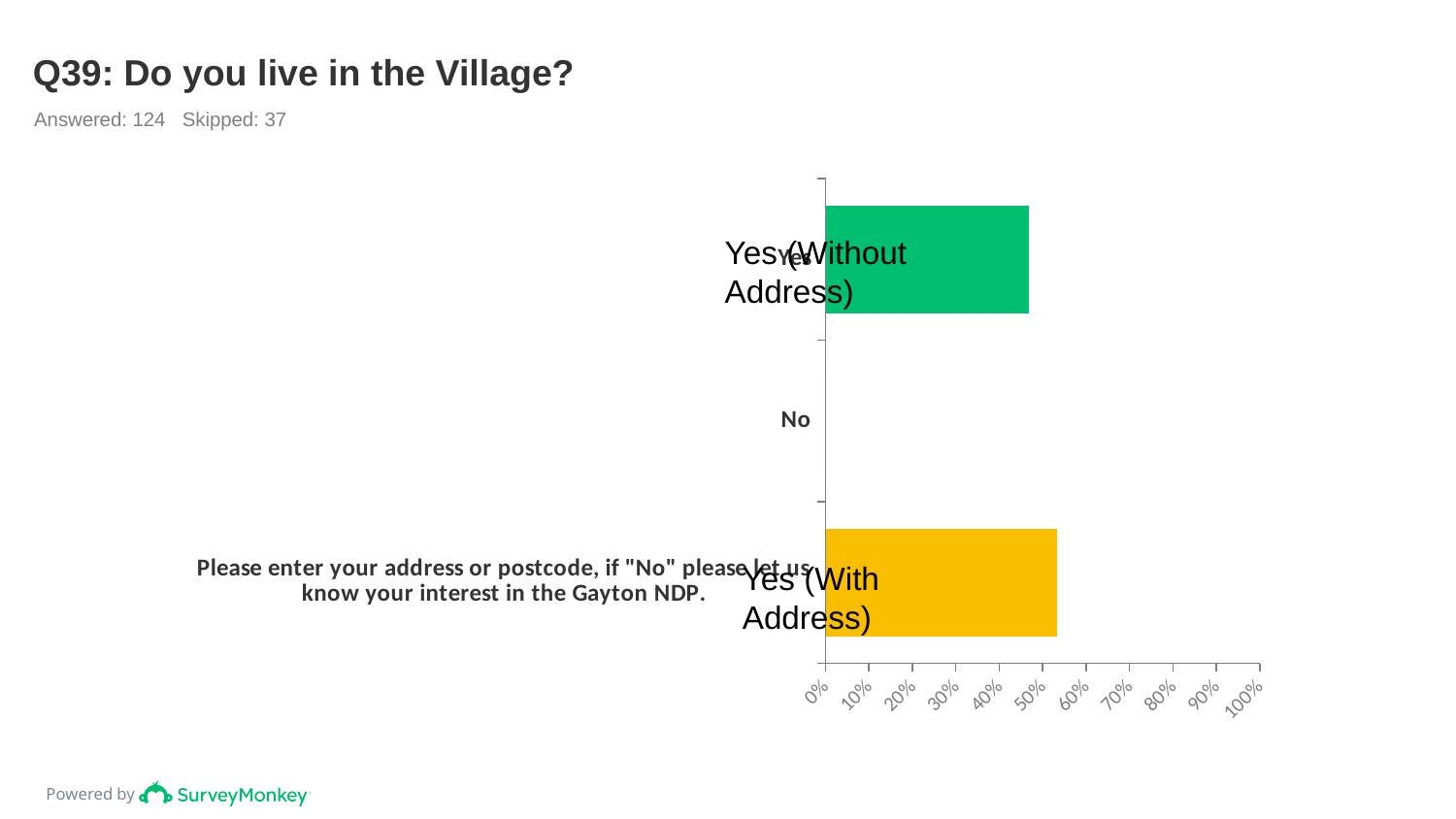
How many categories are shown on the chart? 3 Which category has the highest value? Yes (With Address) Which category has the lowest value? No Is the value for Yes (With Address) greater or less than 40%? greater How many respondents answered the question according to the slide? 124 Is the value for Yes (With Address) greater or less than 60%? less What kind of chart is shown on the slide? Bar chart Is the value for Yes (Without Address) greater or less than 40%? greater Which is larger, the value for Yes (With Address) or the value for Yes (Without Address)? Yes (With Address) What is the title of the chart? Q39: Do you live in the Village?